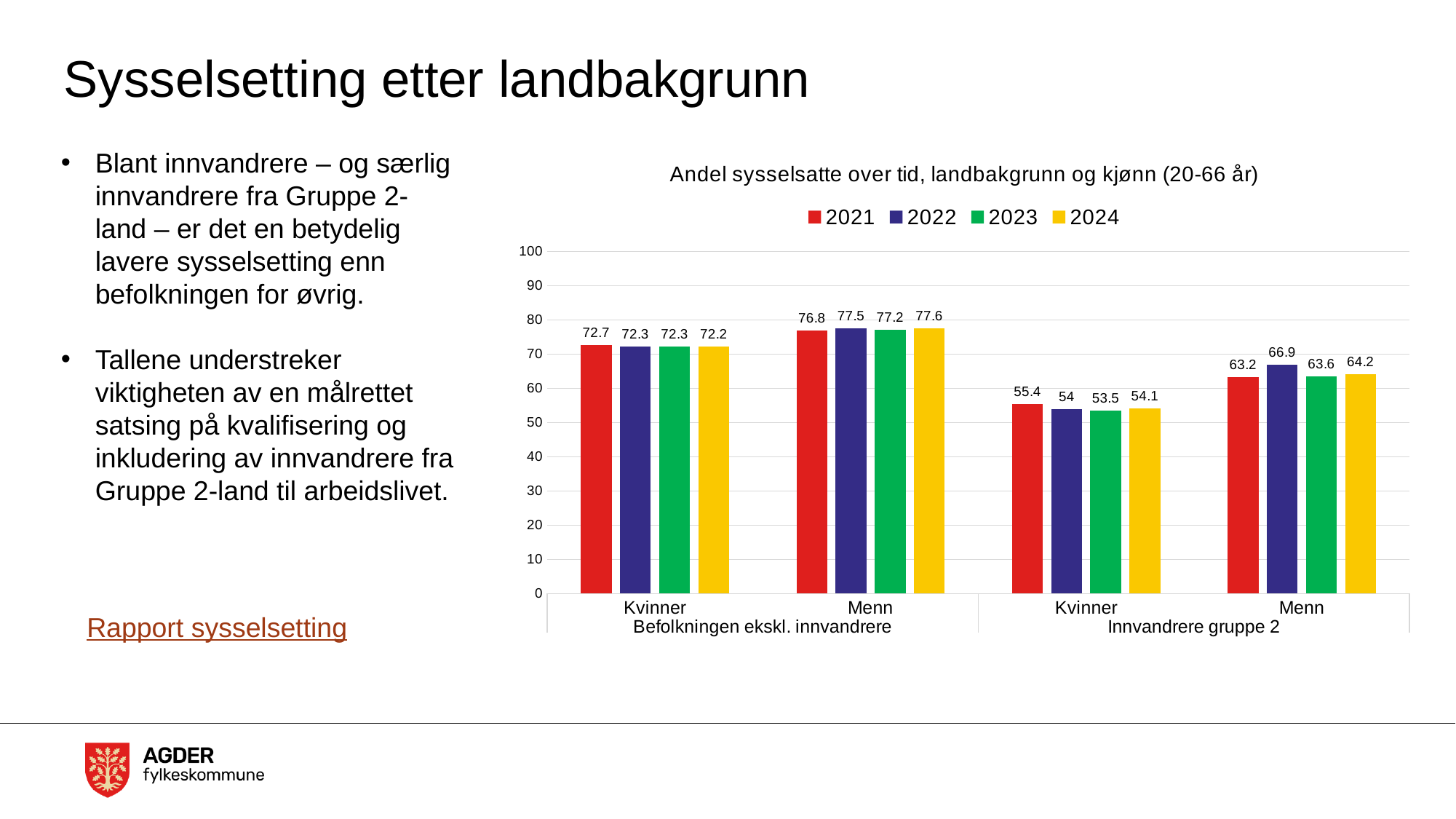
How many series does the legend list? 4 Which category has the lowest 2023 value? Kvinner, Innvandrere gruppe 2 What is the difference between the 2024 values for Menn in Befolkningen ekskl. innvandrere and Menn in Innvandrere gruppe 2? 13.4 What is the title of the chart? Andel sysselsatte over tid, landbakgrunn og kjønn (20-66 år) What is the 2022 value for Kvinner in Innvandrere gruppe 2? 54 How many category groups are shown on the x axis? 4 Which category has the highest 2024 value? Menn, Befolkningen ekskl. innvandrere Is the 2021 value for Kvinner in Innvandrere gruppe 2 greater or less than 60? less What is the 2021 value for Kvinner in Befolkningen ekskl. innvandrere? 72.7 What is the 2024 value for Menn in Innvandrere gruppe 2? 64.2 Which is larger for Menn in Innvandrere gruppe 2: the 2022 value or the 2023 value? 2022 What kind of chart is shown on the slide? bar chart